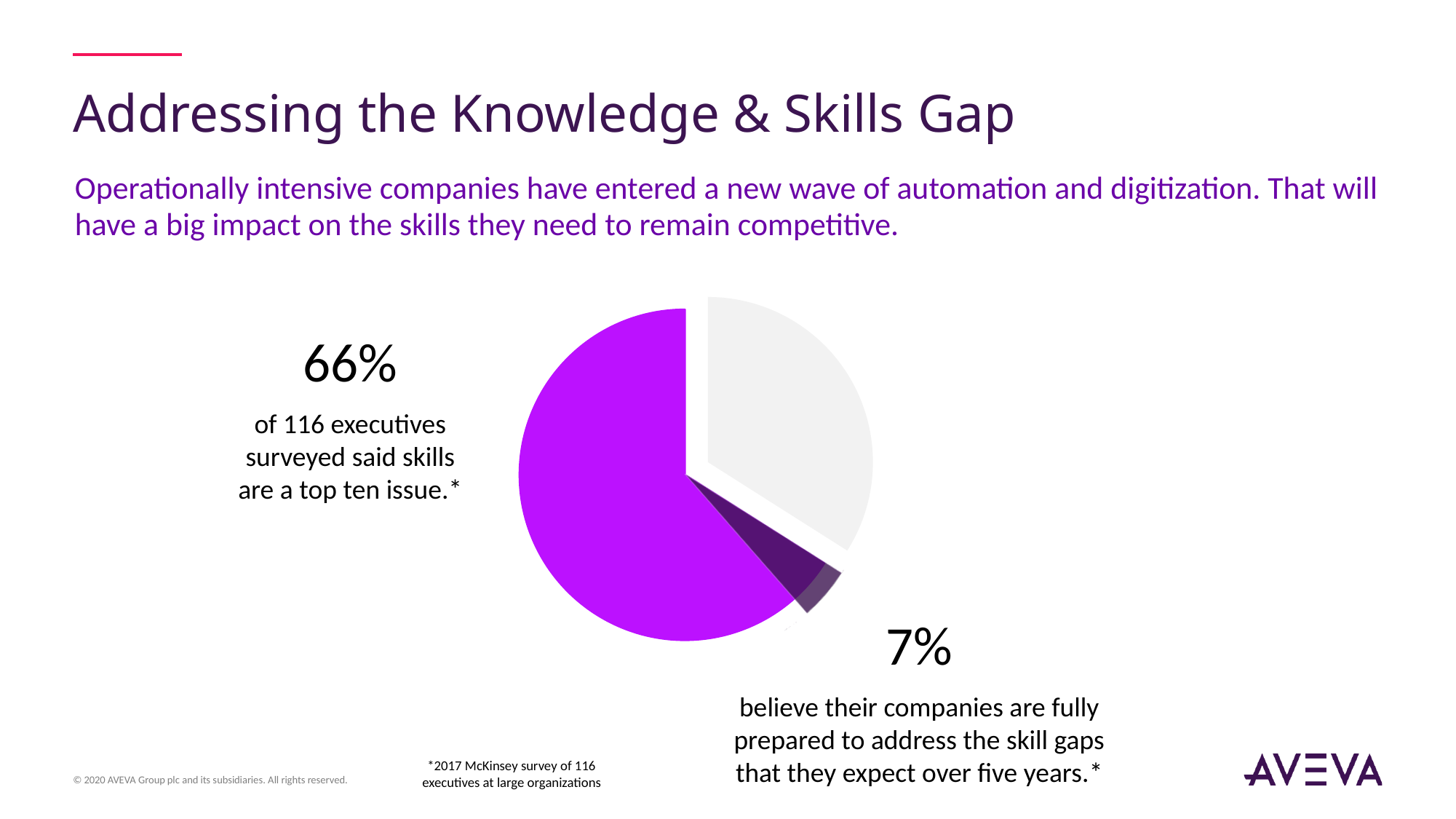
Which is larger: the share of executives who said skills are a top ten issue, or the share who believe their companies are fully prepared to address the skill gaps? Skills are a top ten issue (66%) What percentage of executives believe their companies are fully prepared to address the skill gaps they expect over five years? 7% How many slices does the pie chart have? 3 What share of the pie does the bright purple slice represent? 66% Which slice of the pie chart is the largest? The 66% slice (executives who said skills are a top ten issue) Which slice of the pie chart is the smallest? The 7% slice (believe their companies are fully prepared) What colour is the largest slice of the pie chart? Bright purple What kind of chart is shown on the slide? Pie chart What is the difference in percentage points between the 66% slice and the 7% slice? 59 percentage points How many executives were surveyed according to the slide? 116 What percentage of the 116 executives surveyed said skills are a top ten issue? 66%